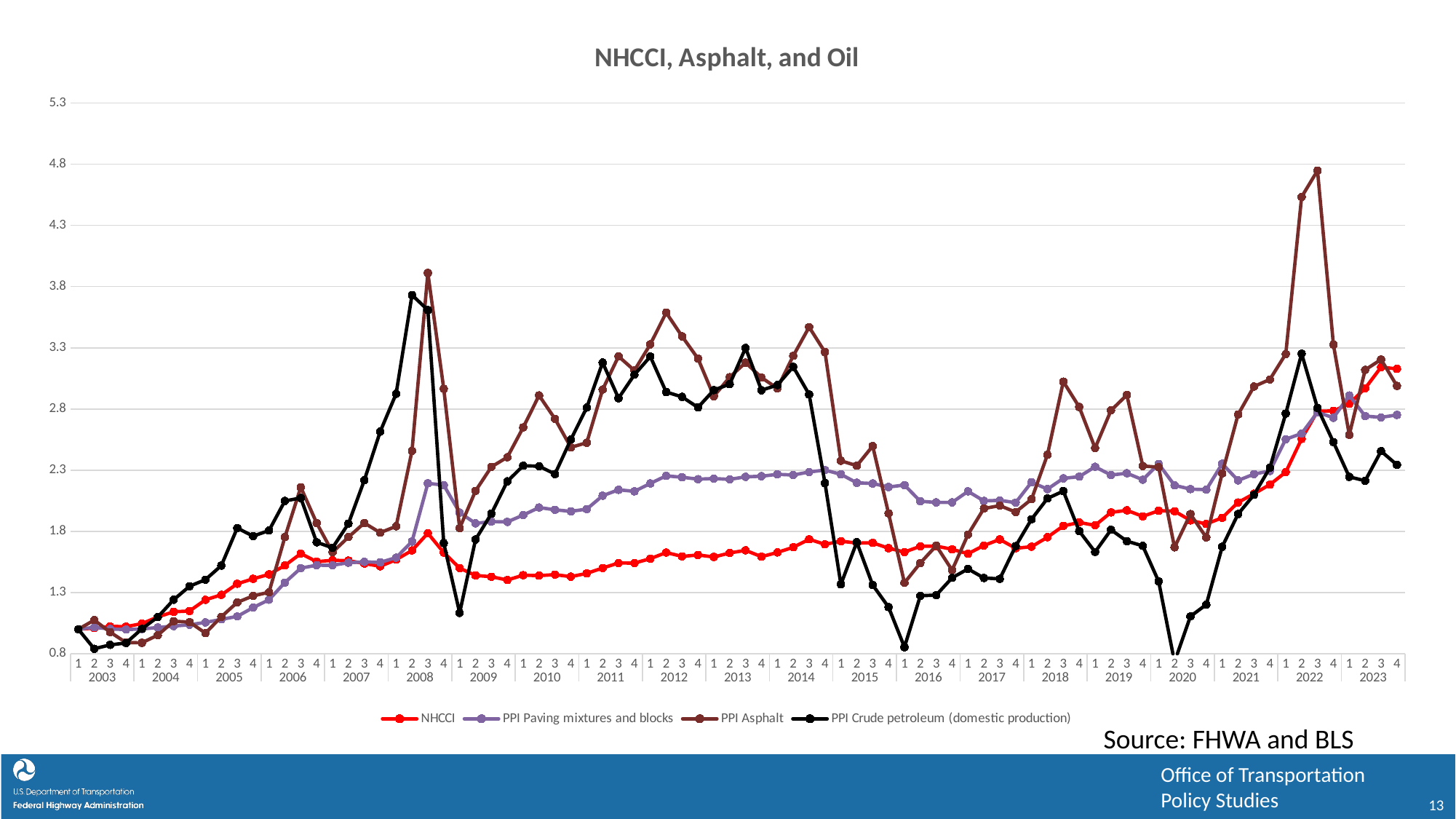
What is the title of the chart? NHCCI, Asphalt, and Oil Is the value for NHCCI in quarter 4 of 2023 greater or less than 2.8? greater Is the value for PPI Crude petroleum (domestic production) in quarter 2 of 2020 greater or less than 1.3? less In quarter 1 of 2015, which is larger: PPI Crude petroleum (domestic production) or PPI Paving mixtures and blocks? PPI Paving mixtures and blocks Is the value for PPI Asphalt in quarter 3 of 2022 greater or less than 4.3? greater How many years are labelled along the x axis? 21 How many series does the legend list? 4 Which series reaches the highest value anywhere on the chart? PPI Asphalt Which series is drawn in red? NHCCI Overall, does the NHCCI series rise or fall from 2003 to 2023? Rise What kind of chart is shown on the slide? Line chart